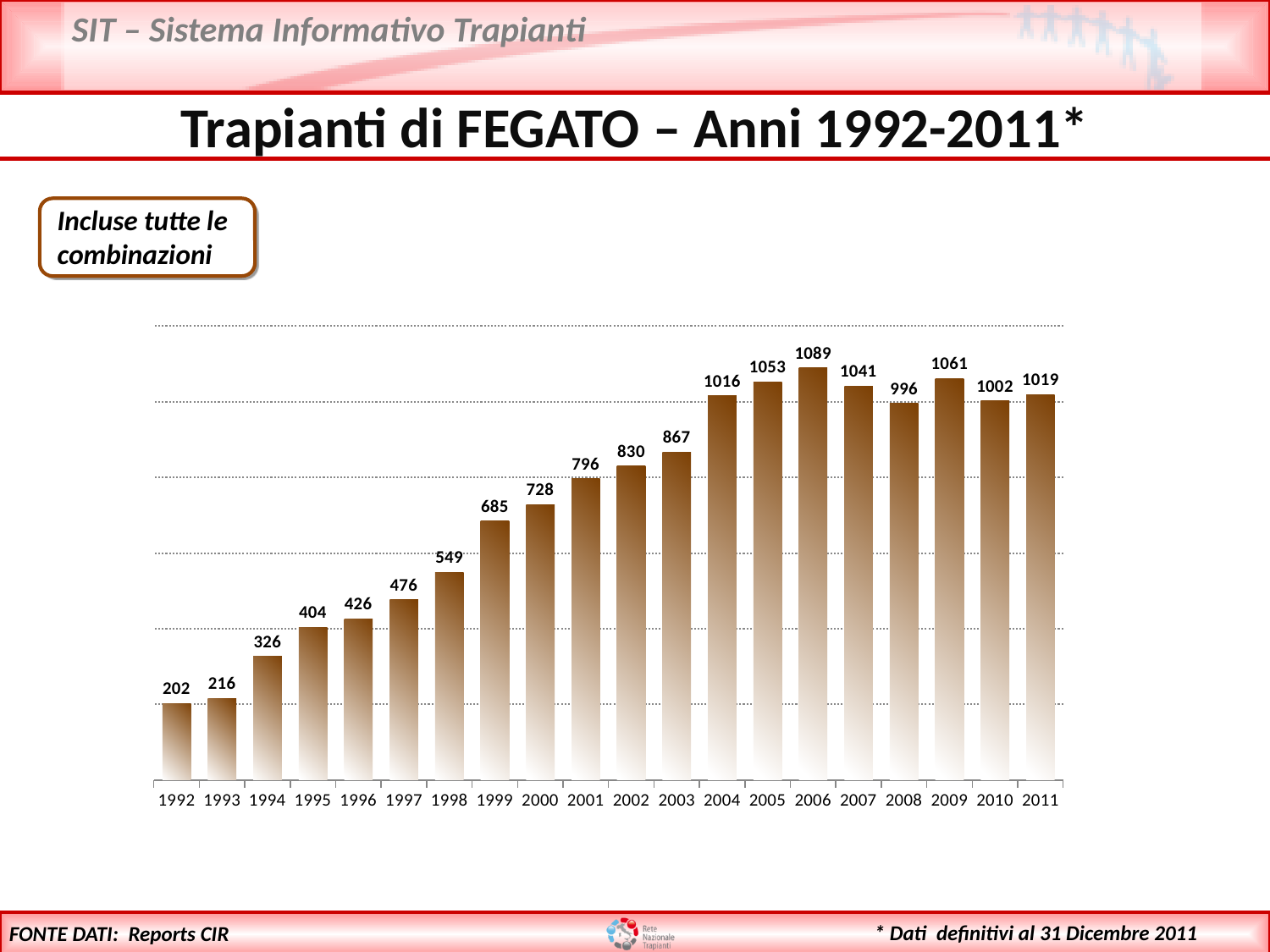
What is the title of the chart? Trapianti di FEGATO – Anni 1992-2011* What is the difference between the values for 2011 and 1992? 817 Do the values generally rise or fall from 1992 to 2004? rise What is the value for 1992? 202 What is the difference between the values for 2006 and 2005? 36 What is the value for 2006? 1089 Which year has the highest value? 2006 What type of chart is shown on the slide? bar chart Which year has the larger value, 2008 or 2009? 2009 How many years are plotted on the chart? 20 What is the value for 1999? 685 Which year has the lowest value? 1992